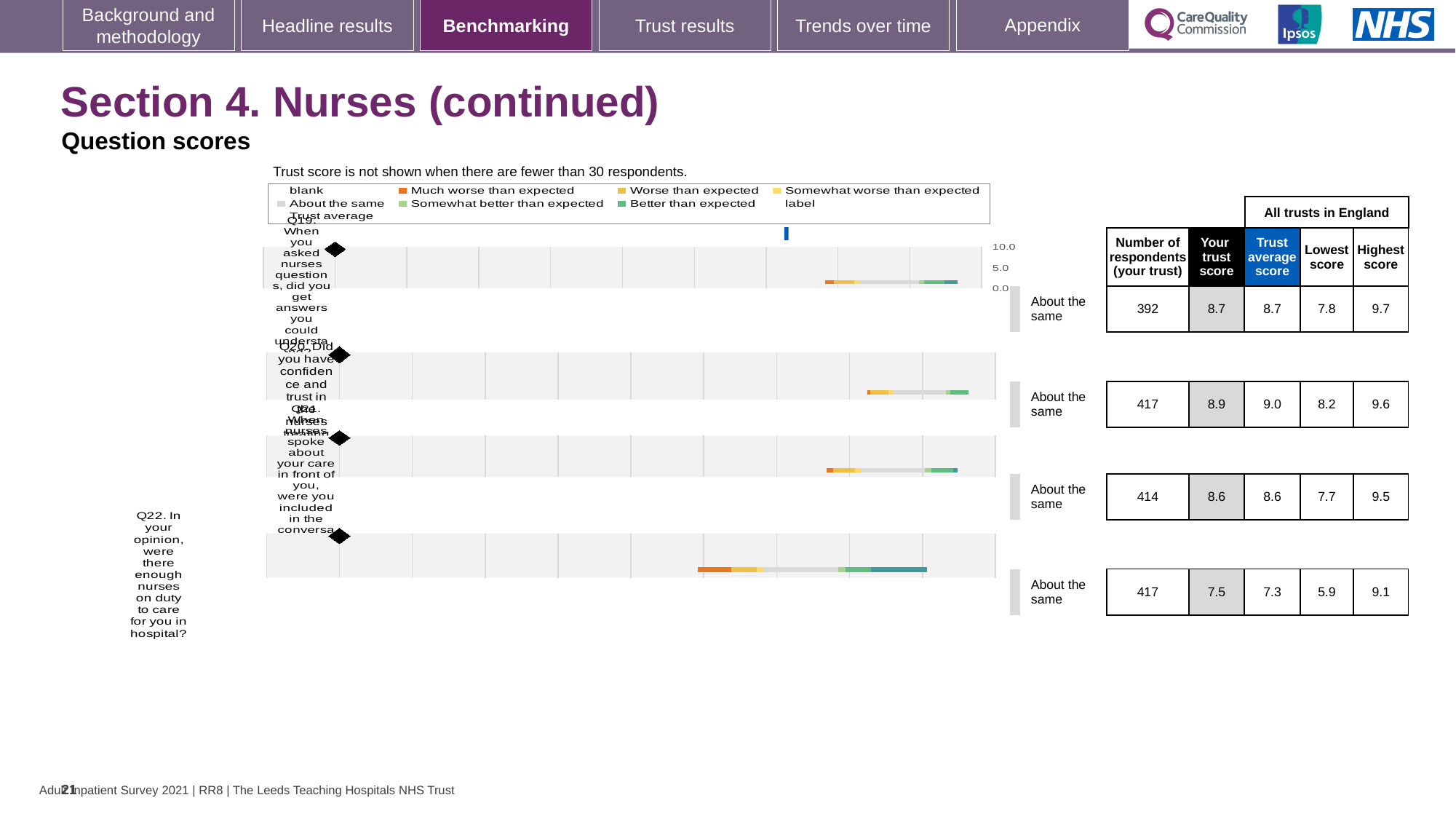
What is the lowest score across all trusts in England for Q22? 5.9 What is the number of respondents for Q19? 392 Which question has the highest 'Your trust score'? Q20 What is the trust average score for Q20 (confidence and trust in nurses)? 9.0 Is the trust score for Q22 greater or less than 5.0? greater Which question has the lowest 'Your trust score'? Q22 What is the difference between the highest score and the lowest score for Q22? 3.2 How many survey questions are plotted on the chart? 4 What is the highest score across all trusts in England for Q21? 9.5 For Q20, which is larger: the trust's own score or the trust average score? Trust average score What benchmark category is shown for all four questions? About the same What is the 'Your trust score' for Q22 (enough nurses on duty)? 7.5